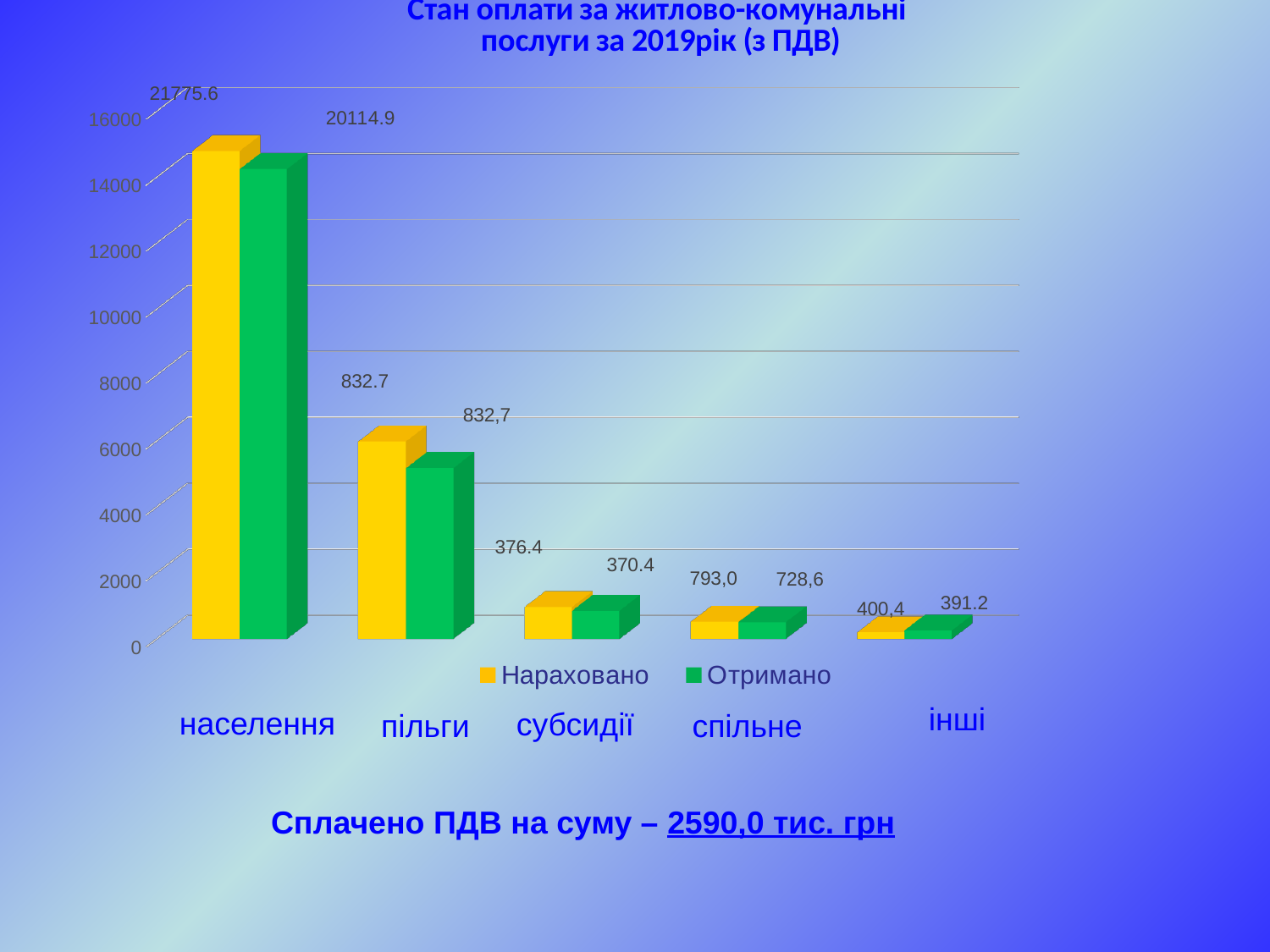
What kind of chart is shown on the slide? bar chart Which category has the highest Нараховано value? населення What is the difference between the Нараховано and Отримано values for населення? 1660.7 Which colour represents the Отримано series? green What is the Отримано value for населення? 20114.9 What is the Отримано value for інші? 391.2 For населення, which is larger: Нараховано or Отримано? Нараховано How many categories are shown on the x axis? 5 What is the Отримано value for субсидії? 370.4 How many series does the legend list? 2 What is the Нараховано value for спільне? 793,0 What is the Нараховано value for населення? 21775.6